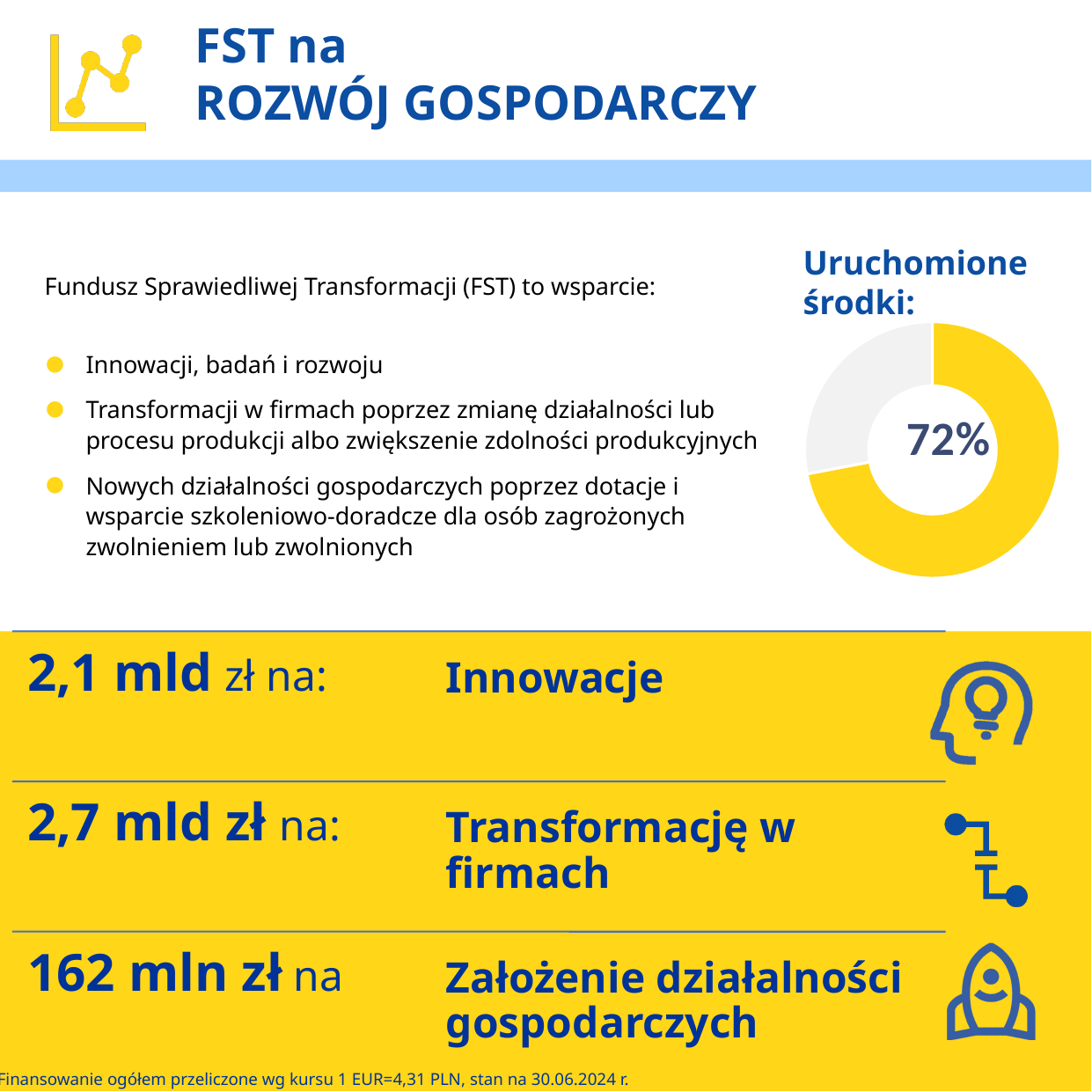
What colour is the segment of the doughnut chart that represents the 72% share? Yellow What kind of chart is shown under the heading "Uruchomione środki:"? Doughnut (pie) chart What is the title above the doughnut chart? Uruchomione środki: How many segments does the doughnut chart have? 2 What percentage is printed in the centre of the doughnut chart? 72% Which segment of the doughnut chart is larger, the yellow one or the grey one? The yellow one Is the share shown by the yellow segment of the doughnut chart greater or less than 50%? greater